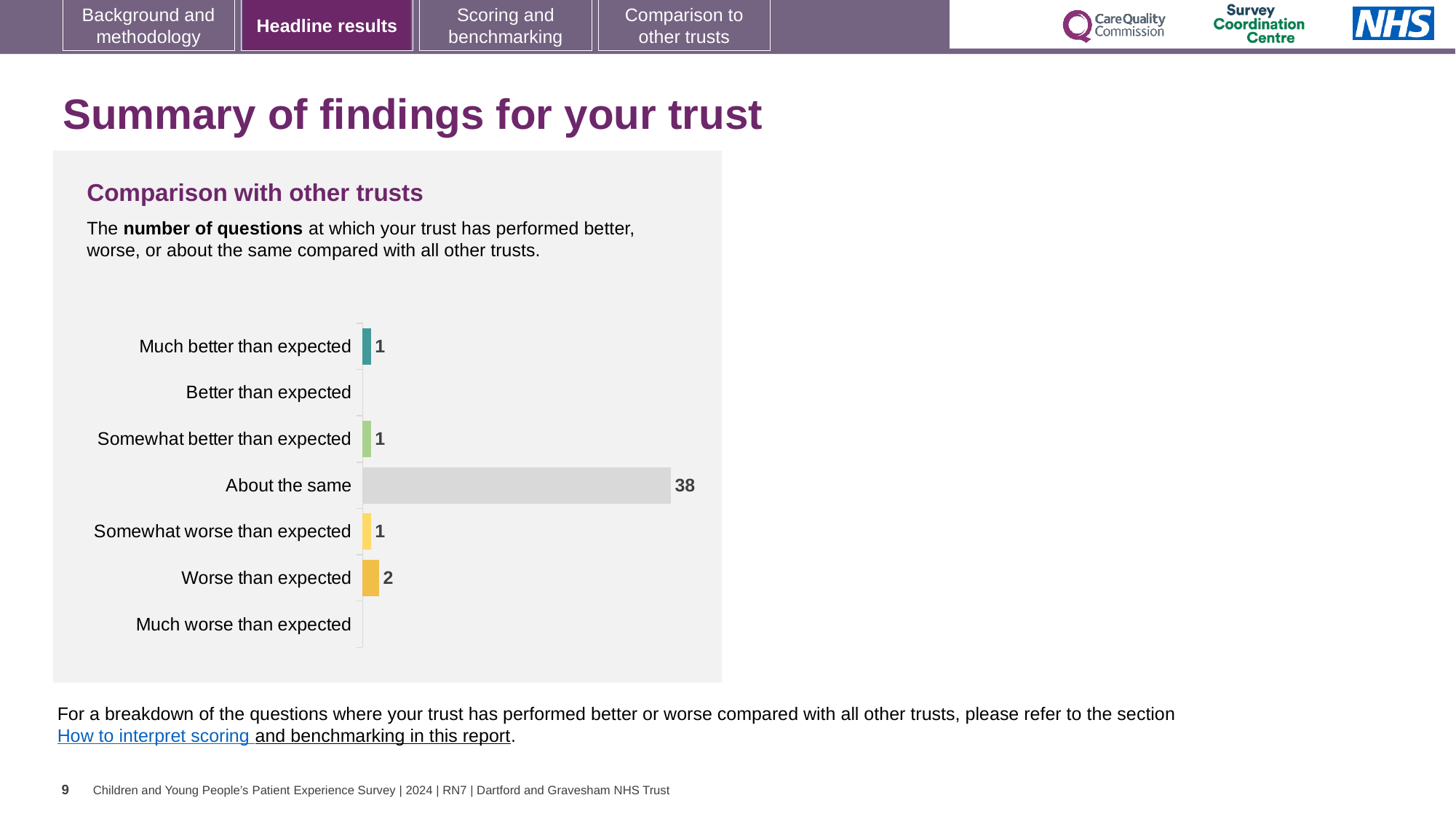
What is the title of the chart section? Comparison with other trusts How many categories are listed on the chart's axis? 7 How many questions were rated 'About the same'? 38 What colour is the 'About the same' bar? Grey What is the value for 'Much better than expected'? 1 What is the value for 'Worse than expected'? 2 What is the total number of questions across all categories shown? 43 Which category has the highest number of questions? About the same What is the difference between 'About the same' and 'Worse than expected'? 36 What kind of chart is shown on the slide? Bar chart What is the value for 'Somewhat worse than expected'? 1 Which is larger, 'Worse than expected' or 'Somewhat worse than expected'? Worse than expected